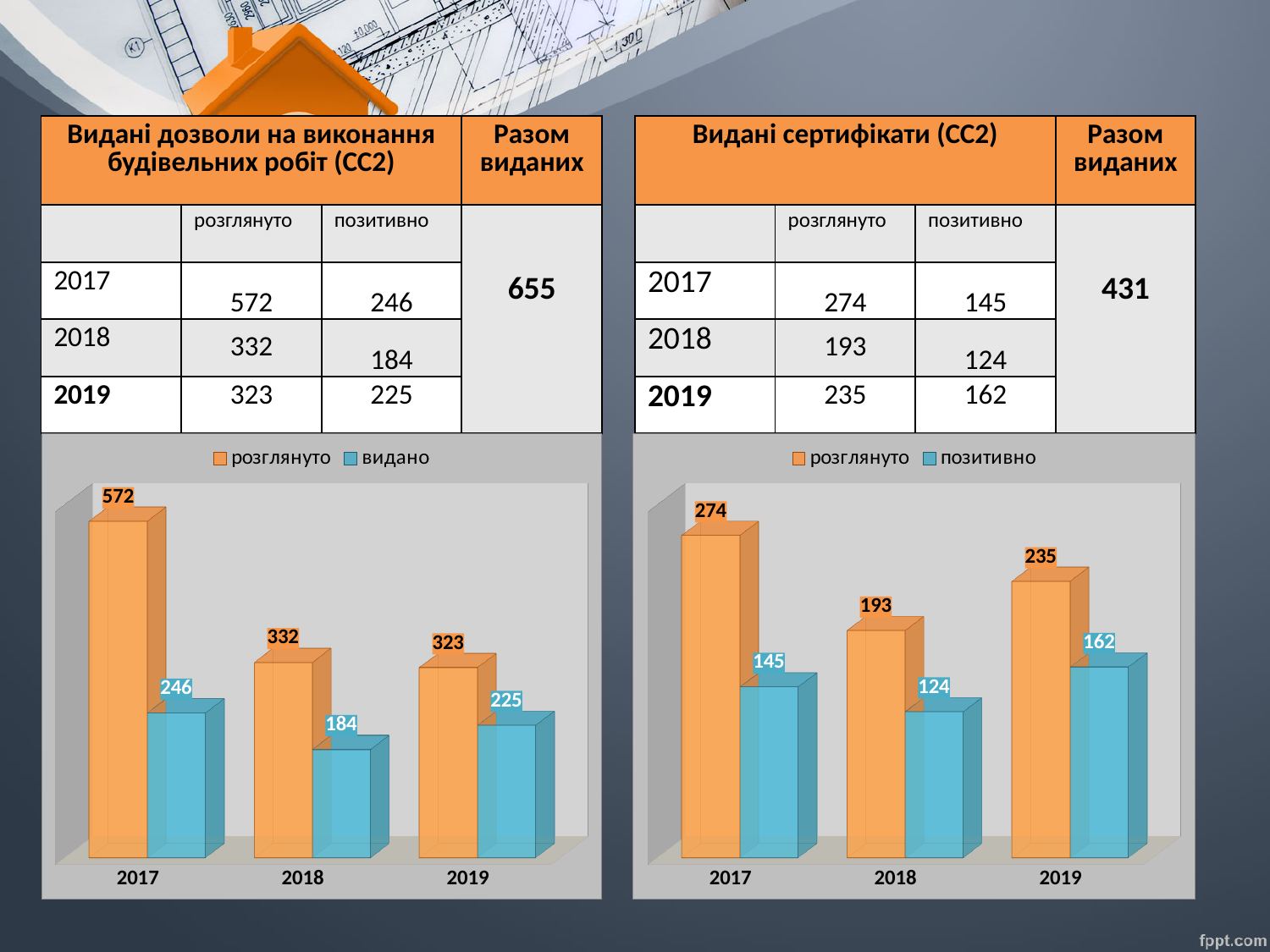
In the right chart, what is the value of розглянуто for 2018? 193 How many series does the legend of the left chart list? 2 In the left chart, which is larger: видано for 2017 or видано for 2019? видано for 2017 What type of chart is the right chart? bar chart In the left chart, which year has the highest розглянуто value? 2017 How many years are shown on the x axis of the right chart? 3 In the right chart, what is the difference between розглянуто for 2017 and розглянуто for 2019? 39 In the left chart, what is the value of розглянуто for 2017? 572 In the left chart, what is the value of видано for 2018? 184 In the right chart, which year has the lowest позитивно value? 2018 In the left chart, what is the difference between розглянуто and видано for 2019? 98 In the right chart, what is the value of позитивно for 2019? 162